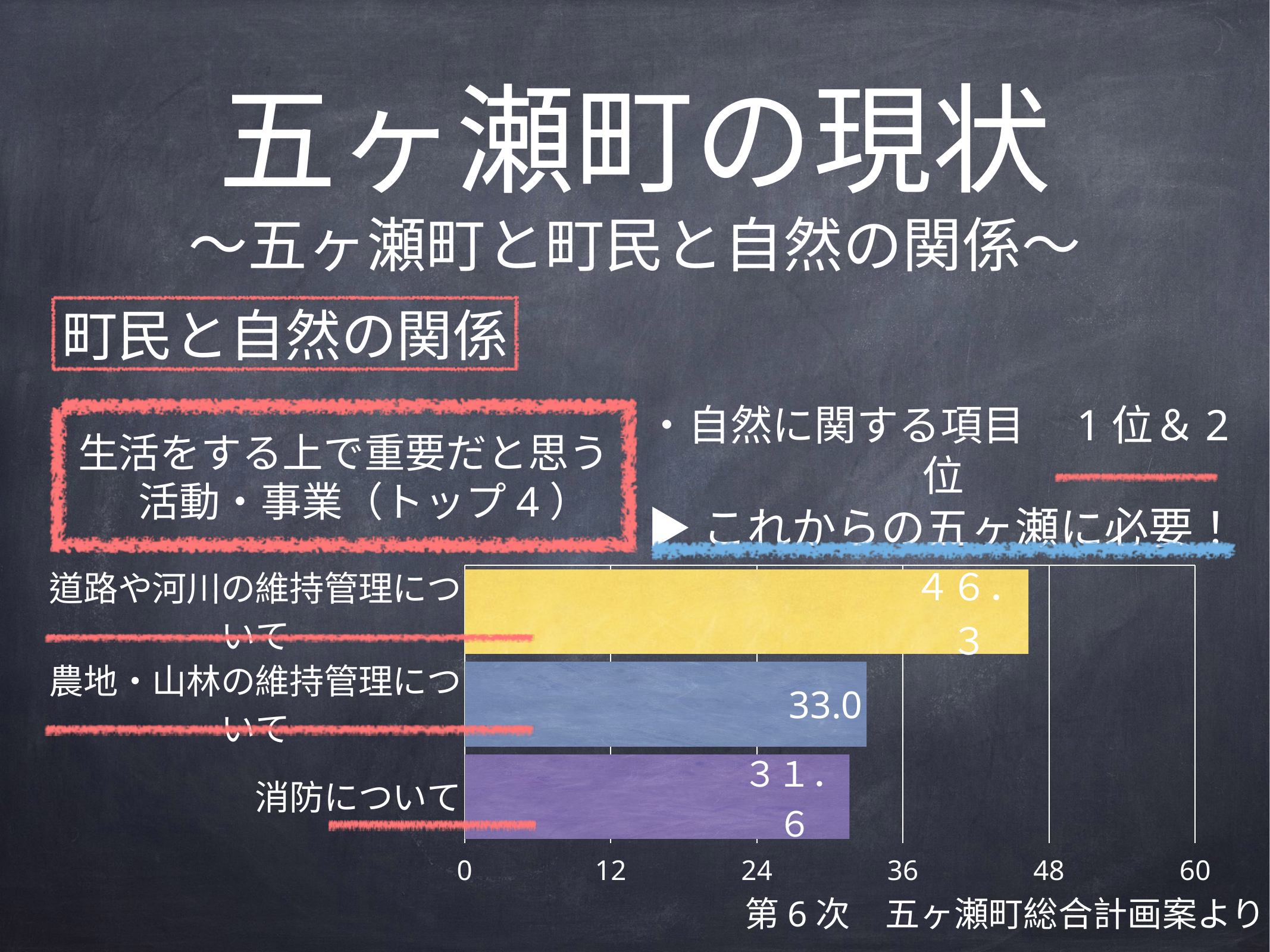
What kind of chart is shown on the slide? bar chart Which is larger, the value for 道路や河川の維持管理について or the value for 消防について? 道路や河川の維持管理について Which category has the lowest value? 消防について What is the value for 農地・山林の維持管理について? 33.0 What colour is the bar for 消防について? purple What is the difference between the values for 道路や河川の維持管理について and 農地・山林の維持管理について? 13.3 What is the value for 道路や河川の維持管理について? 46.3 What is the difference between the values for 農地・山林の維持管理について and 消防について? 1.4 How many categories are shown in the chart? 3 Is the value for 道路や河川の維持管理について greater or less than 48? less What is the value for 消防について? 31.6 Which category has the highest value? 道路や河川の維持管理について